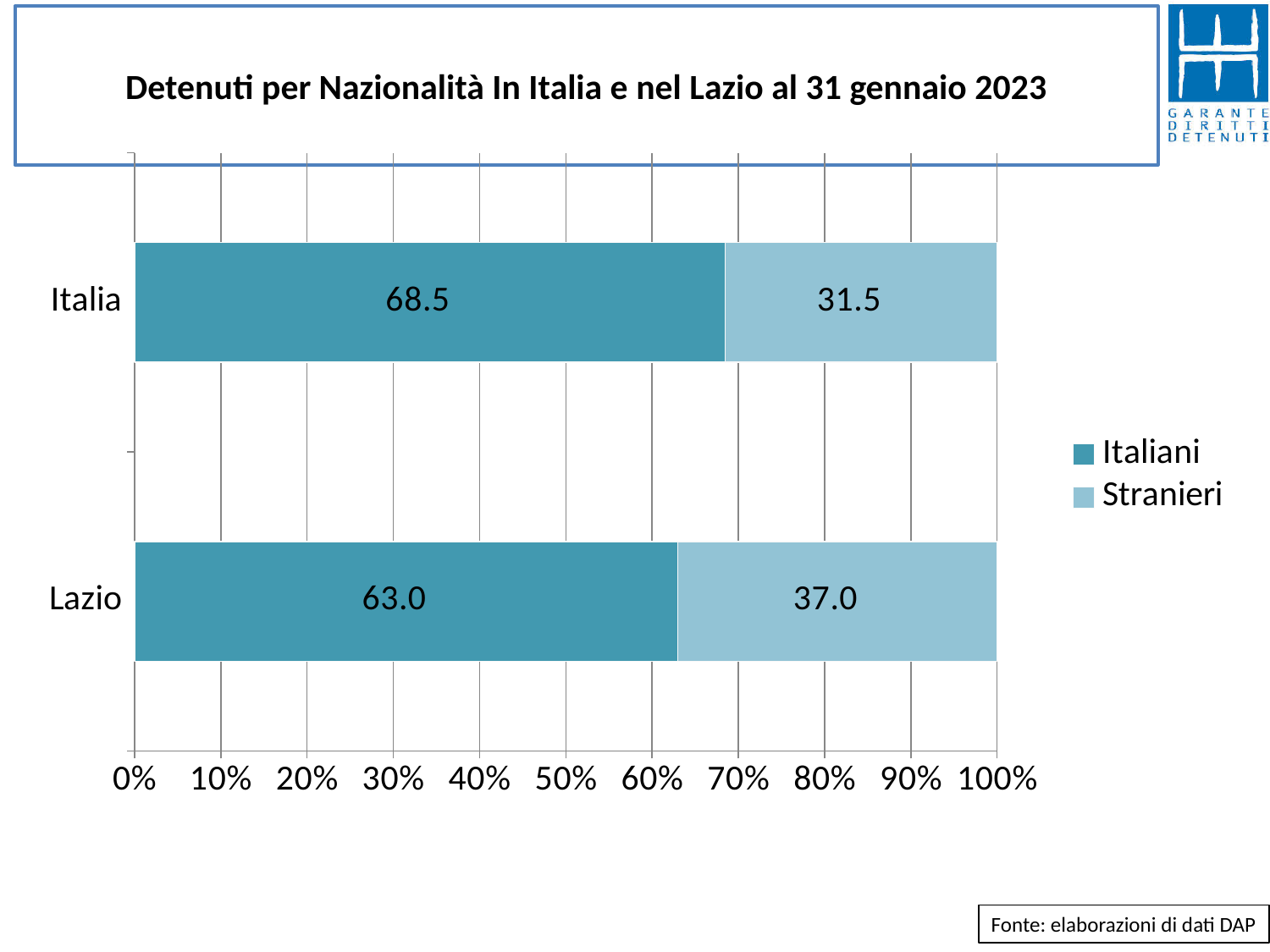
What is the value for Italiani in Italia? 68.5 What kind of chart is shown on the slide? Stacked bar chart What is the value for Stranieri in Lazio? 37.0 Which category has the higher value for Italiani, Italia or Lazio? Italia How many series does the legend list? 2 What is the difference between the Italiani and Stranieri values for Lazio? 26.0 Which category has the higher value for Stranieri, Italia or Lazio? Lazio What is the value for Stranieri in Italia? 31.5 What is the value for Italiani in Lazio? 63.0 How many categories are shown on the chart? 2 What is the total of the stacked bar for Italia? 100.0 What is the difference between the Italiani values for Italia and Lazio? 5.5